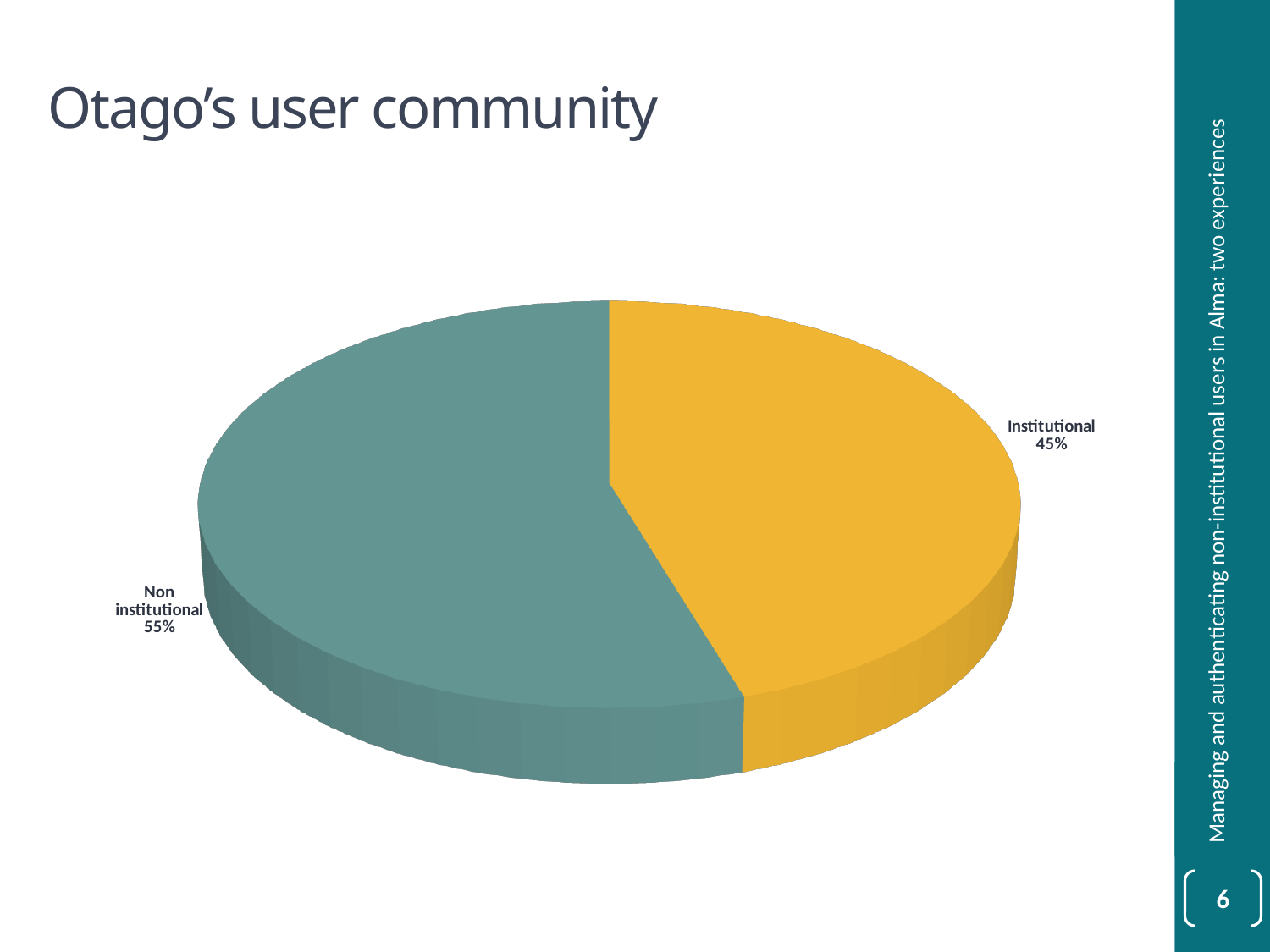
Which slice is the smallest? Institutional What colour is the Institutional slice? yellow What is the difference in percentage points between Non institutional and Institutional? 10% Which slice is the largest? Non institutional What is the title of the slide containing the pie chart? Otago's user community How many slices does the pie chart have? 2 Which is larger, Institutional or Non institutional? Non institutional What kind of chart is shown on the slide? pie chart What share of the pie is Institutional? 45% What share of the pie is Non institutional? 55%